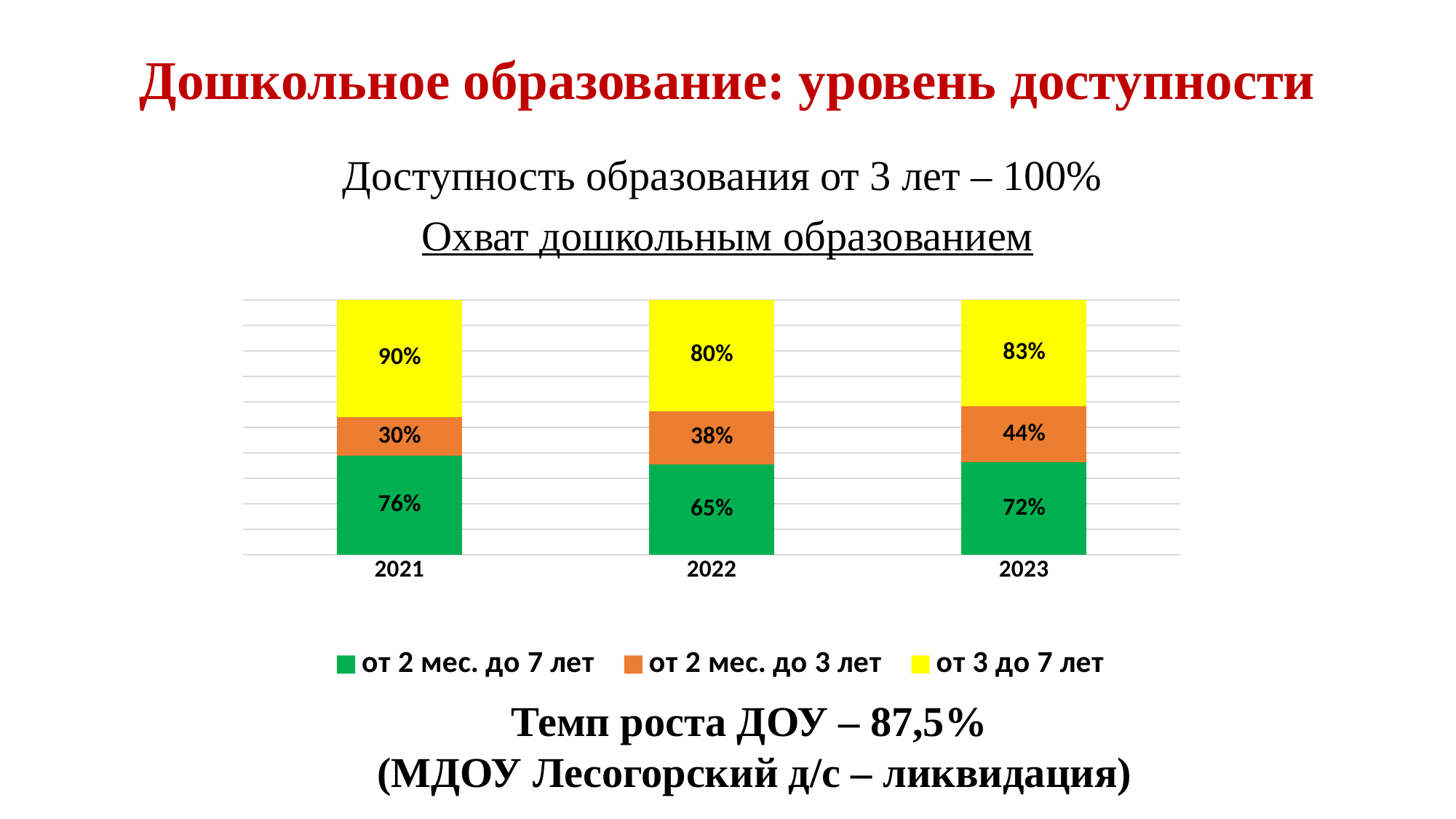
What kind of chart is shown on the slide? Stacked bar chart In which year is the value for "от 2 мес. до 7 лет" lowest? 2022 In which year is the value for "от 2 мес. до 3 лет" highest? 2023 What is the difference between the "от 3 до 7 лет" values for 2021 and 2022? 10% How many years are shown on the x axis? 3 Does the value for "от 2 мес. до 3 лет" rise or fall from 2021 to 2023? Rise What is the value for "от 2 мес. до 3 лет" in 2023? 44% What is the value for "от 2 мес. до 7 лет" in 2021? 76% Which colour represents the series "от 3 до 7 лет" in the legend? Yellow How many series does the legend list? 3 Which is larger: the "от 2 мес. до 7 лет" value for 2021 or for 2023? 2021 What is the value for "от 3 до 7 лет" in 2022? 80%